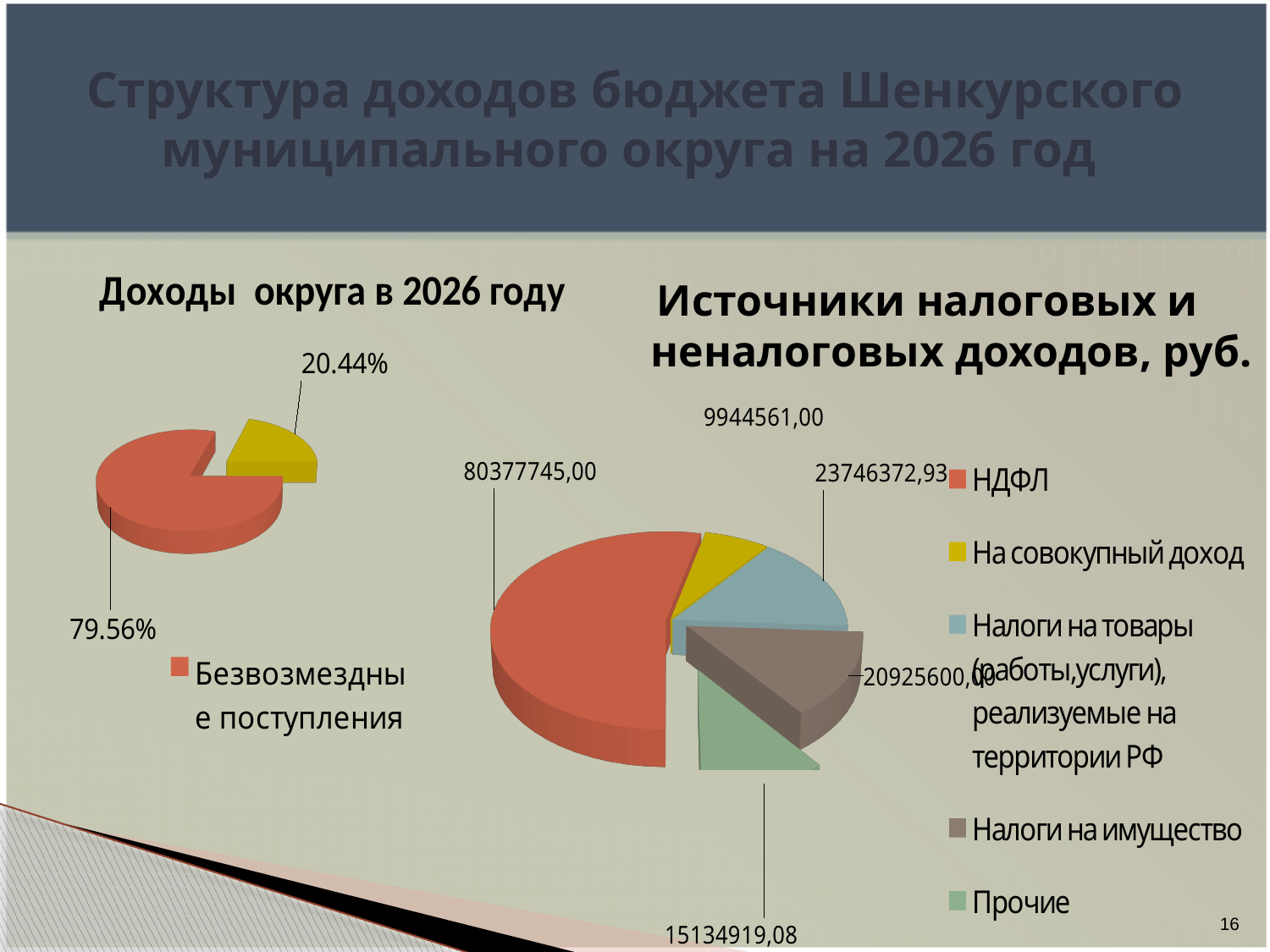
In the chart 'Доходы округа в 2026 году', what share of the pie is 'Безвозмездные поступления'? 79.56% In the chart 'Источники налоговых и неналоговых доходов, руб.', what is the value for 'Налоги на имущество'? 20925600,00 What kind of chart is 'Доходы округа в 2026 году'? Pie chart In the chart 'Источники налоговых и неналоговых доходов, руб.', what is the value for 'Прочие'? 15134919,08 In the chart 'Источники налоговых и неналоговых доходов, руб.', what is the value for 'На совокупный доход'? 9944561,00 In the chart 'Источники налоговых и неналоговых доходов, руб.', which category has the largest value? НДФЛ In the chart 'Источники налоговых и неналоговых доходов, руб.', which category has the smallest value? На совокупный доход In the chart 'Источники налоговых и неналоговых доходов, руб.', what is the difference between the values for 'НДФЛ' and 'Налоги на имущество'? 59452145,00 In the chart 'Источники налоговых и неналоговых доходов, руб.', what is the value for 'Налоги на товары (работы,услуги), реализуемые на территории РФ'? 23746372,93 How many categories does the legend of the chart 'Источники налоговых и неналоговых доходов, руб.' list? 5 In the chart 'Доходы округа в 2026 году', what percentage is shown for the yellow slice? 20.44% In the chart 'Источники налоговых и неналоговых доходов, руб.', what is the value for 'НДФЛ'? 80377745,00